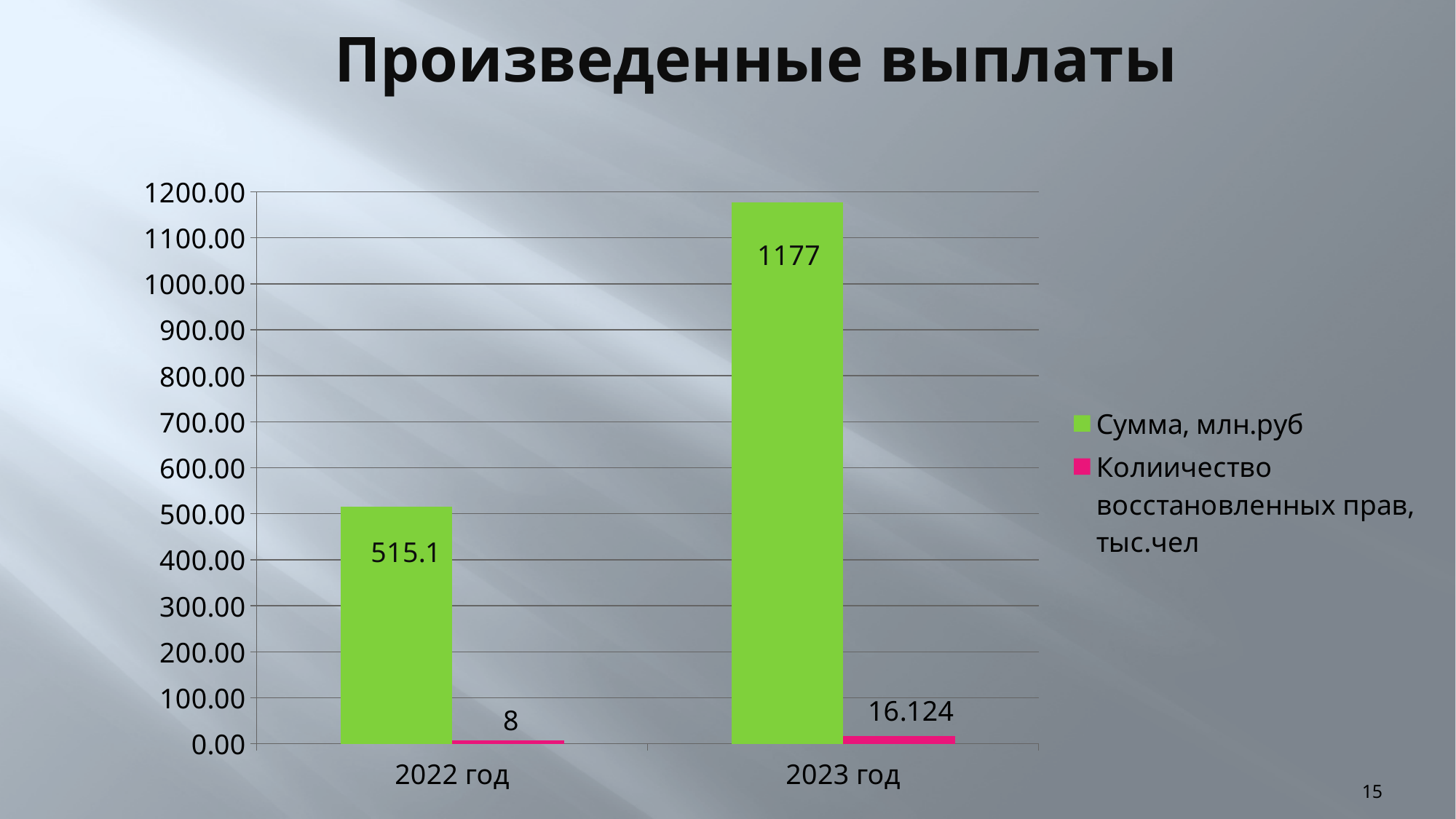
What is the value of 'Колиичество восстановленных прав, тыс.чел' for 2022 год? 8 Which year has the higher value for 'Сумма, млн.руб'? 2023 год What is the title of the chart? Произведенные выплаты What is the difference between the 'Сумма, млн.руб' values for 2023 год and 2022 год? 661.9 Is the 'Сумма, млн.руб' value for 2022 год greater or less than 600.00? less What is the value of 'Сумма, млн.руб' for 2022 год? 515.1 How many series does the legend list? 2 How many categories are shown on the x axis? 2 What is the value of 'Колиичество восстановленных прав, тыс.чел' for 2023 год? 16.124 What kind of chart is shown on the slide? bar chart Which year has the lower value for 'Колиичество восстановленных прав, тыс.чел'? 2022 год What is the value of 'Сумма, млн.руб' for 2023 год? 1177